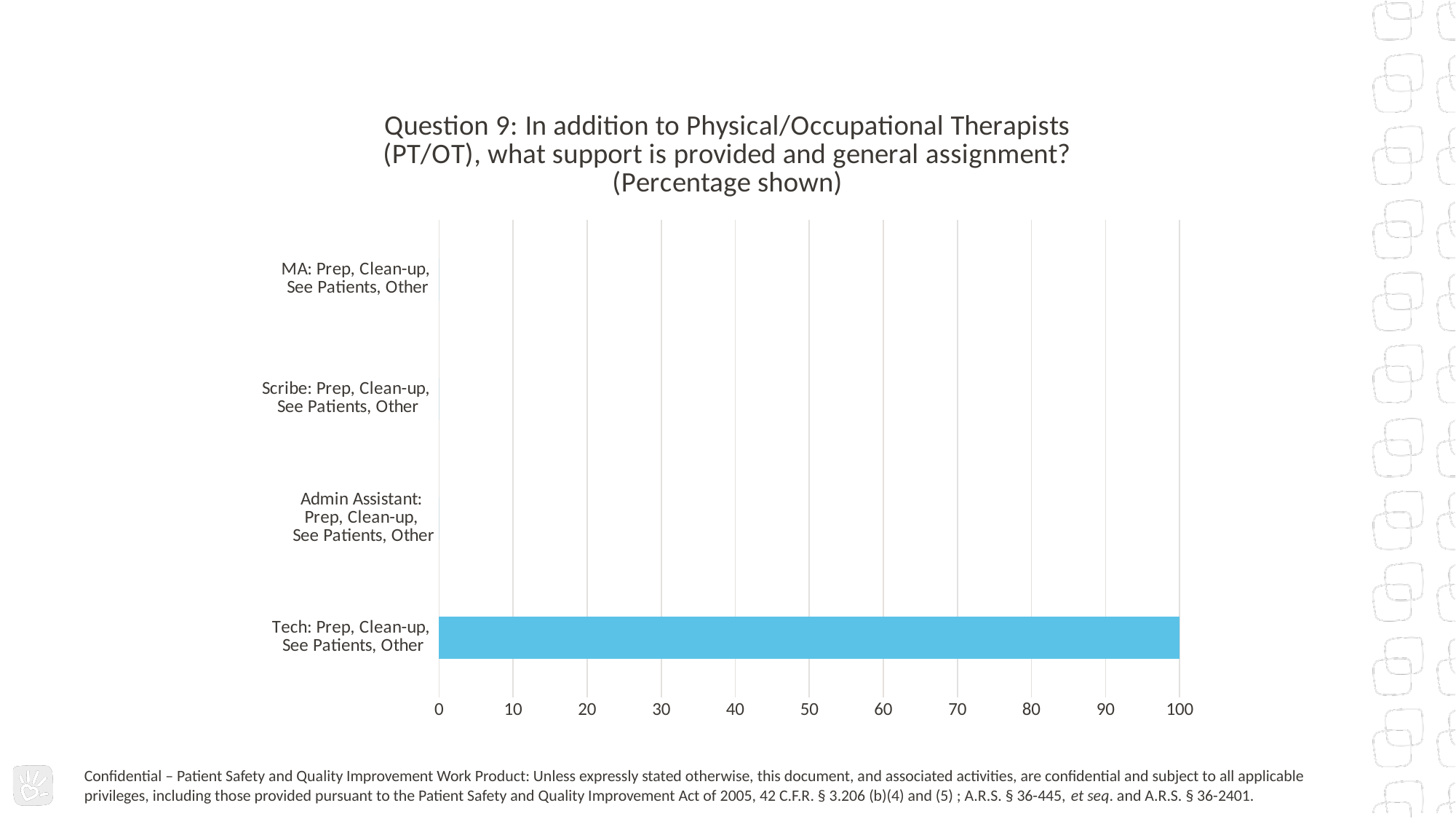
What is the title of the chart? Question 9: In addition to Physical/Occupational Therapists (PT/OT), what support is provided and general assignment? (Percentage shown) How many categories in the chart have a visible bar? 1 What is the maximum value shown on the horizontal axis of the chart? 100 Is the value for MA: Prep, Clean-up, See Patients, Other greater or less than 10? less Which is larger, the value for Tech: Prep, Clean-up, See Patients, Other or the value for Admin Assistant: Prep, Clean-up, See Patients, Other? Tech: Prep, Clean-up, See Patients, Other Which category has the highest value in the chart? Tech: Prep, Clean-up, See Patients, Other Is the value for Tech: Prep, Clean-up, See Patients, Other greater or less than 50? greater What is the value for Tech: Prep, Clean-up, See Patients, Other? 100 How many categories are listed on the vertical axis of the chart? 4 What kind of chart is shown on the slide? bar chart Is the value for Scribe: Prep, Clean-up, See Patients, Other greater or less than 10? less